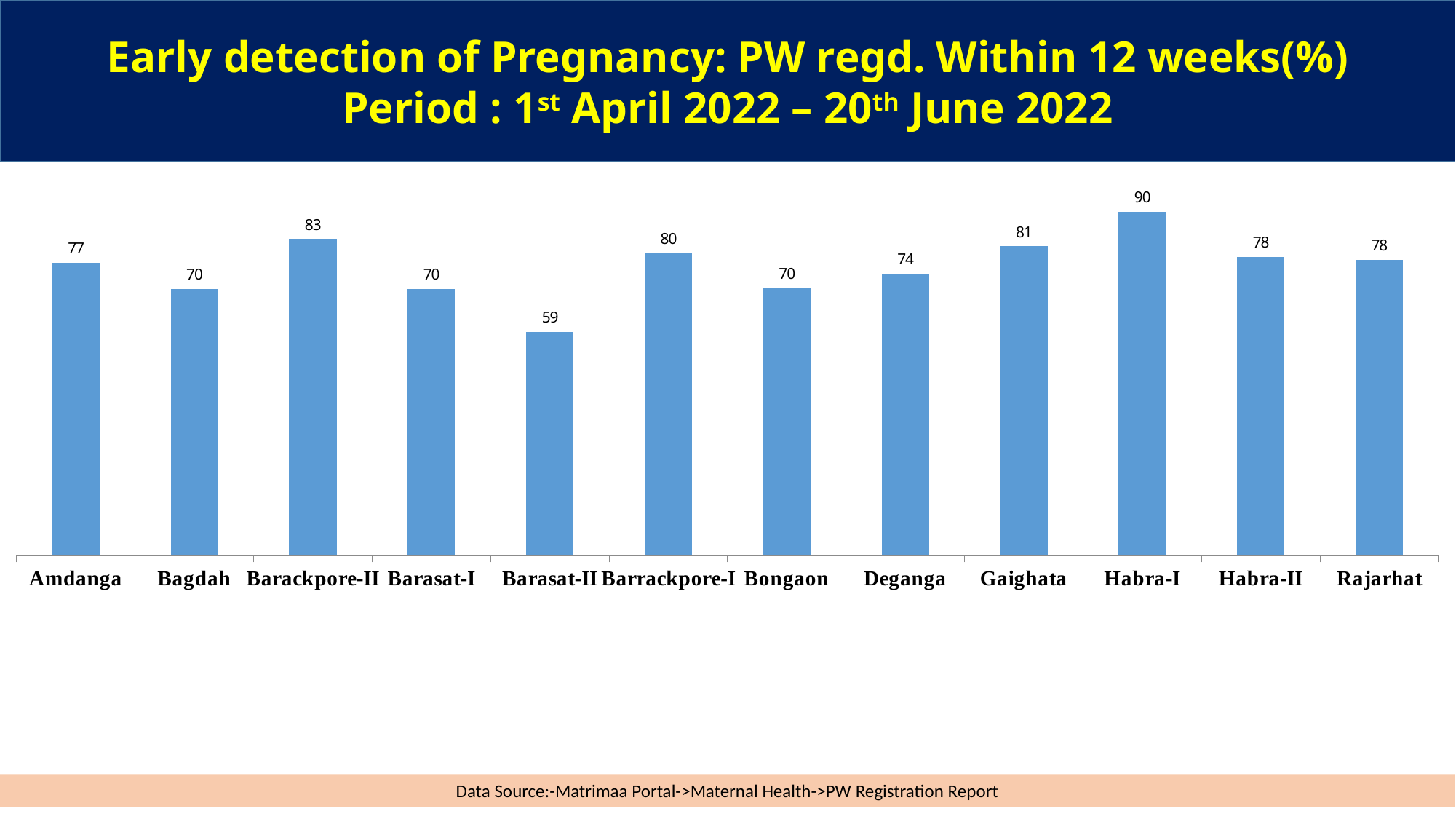
What is the difference between the values for Barackpore-II and Bagdah? 13 Which block has the highest value? Habra-I How many blocks are shown on the chart? 12 What is the value for Barasat-II? 59 What is the value for Deganga? 74 What is the value for Habra-I? 90 What is the difference between the values for Habra-I and Barasat-II? 31 Which block has the lowest value? Barasat-II What data source is cited at the bottom of the slide? Matrimaa Portal->Maternal Health->PW Registration Report What kind of chart is shown on the slide? Bar chart Which is larger, the value for Barrackpore-I or the value for Amdanga? Barrackpore-I What is the value for Gaighata? 81